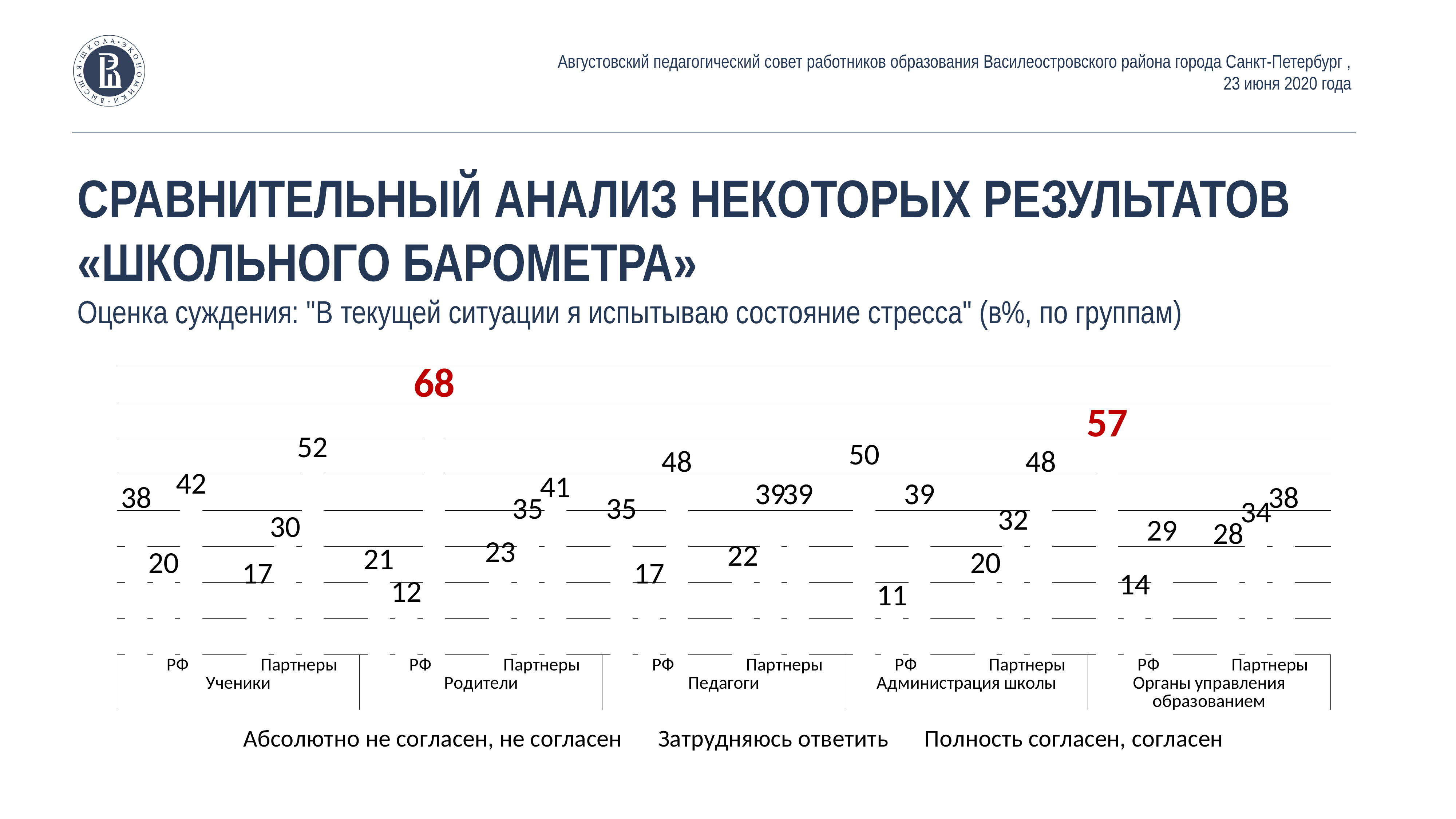
What is the highest value labelled on the chart? 68 What is the first legend entry of the chart? Абсолютно не согласен, не согласен What is the largest value for Органы управления образованием, РФ? 57 How many respondent groups (Ученики, Родители, etc.) are shown along the x axis? 5 How many series does the legend list? 3 Which is larger: the highest value for Ученики, Партнеры (52) or the highest value for Педагоги, РФ (48)? Ученики, Партнеры (52) Which two values are highlighted in red on the chart? 68 and 57 What is the lowest value labelled on the chart? 11 What is the difference between the two red-highlighted values, 68 and 57? 11 What is the value for 'Абсолютно не согласен, не согласен' for Родители, РФ? 21 Which group and sample has the lowest labelled value, 11? Администрация школы, РФ Which group and sample has the highest labelled value, 68? Родители, РФ